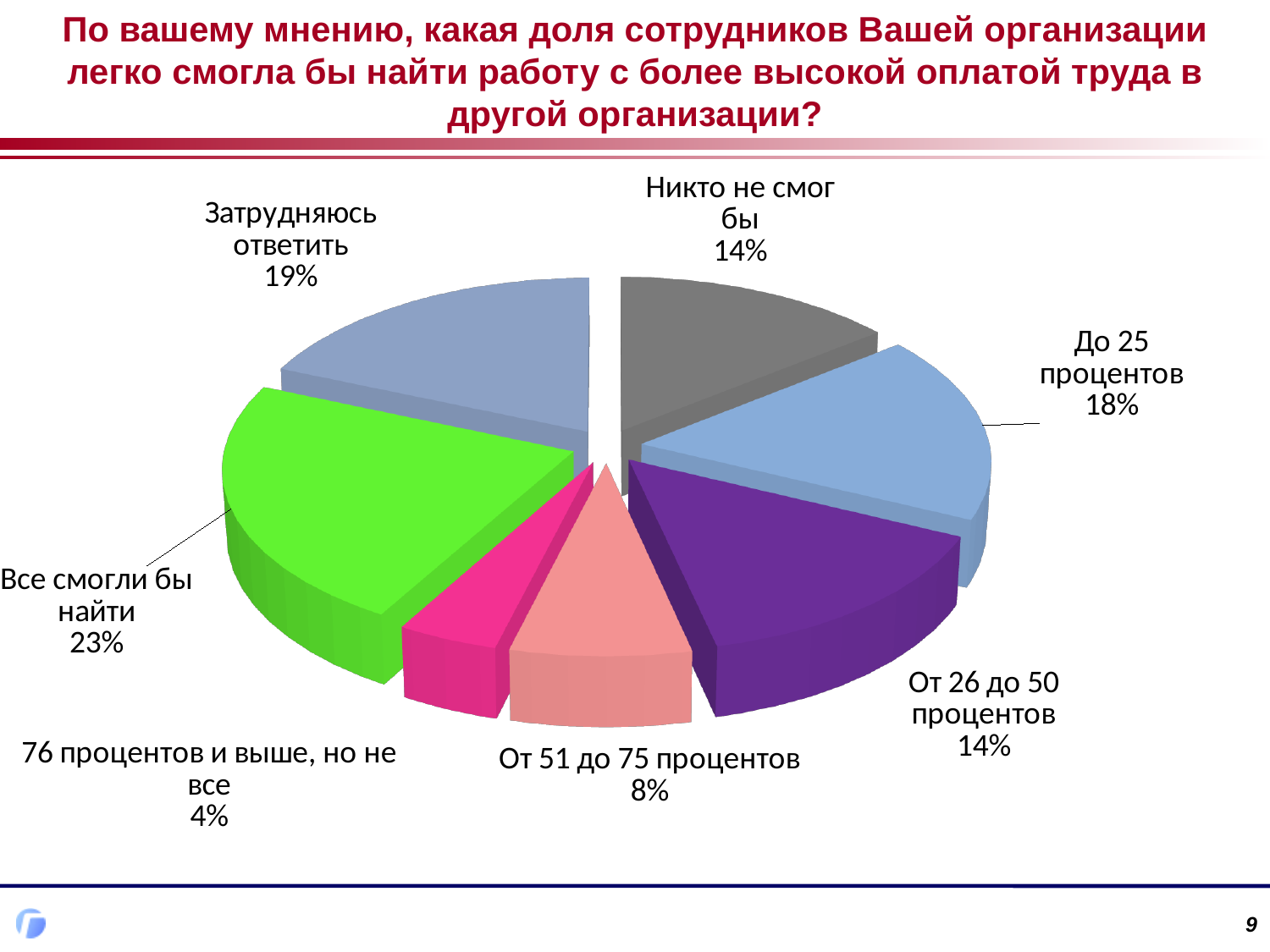
What is the value shown for "До 25 процентов"? 18% What kind of chart is shown on the slide? Pie chart What is the difference between the shares for "Все смогли бы найти" and "Затрудняюсь ответить"? 4% What is the value shown for "От 51 до 75 процентов"? 8% What share of the pie is labelled "Все смогли бы найти"? 23% What is the value shown for "Затрудняюсь ответить"? 19% What is the combined share of "Никто не смог бы" and "От 26 до 50 процентов"? 28% Which category has the smallest share of the pie? 76 процентов и выше, но не все Which is larger: the share for "До 25 процентов" or the share for "От 51 до 75 процентов"? До 25 процентов What colour is the slice for "Все смогли бы найти"? Green How many slices does the pie chart have? 7 Which category has the largest share of the pie? Все смогли бы найти